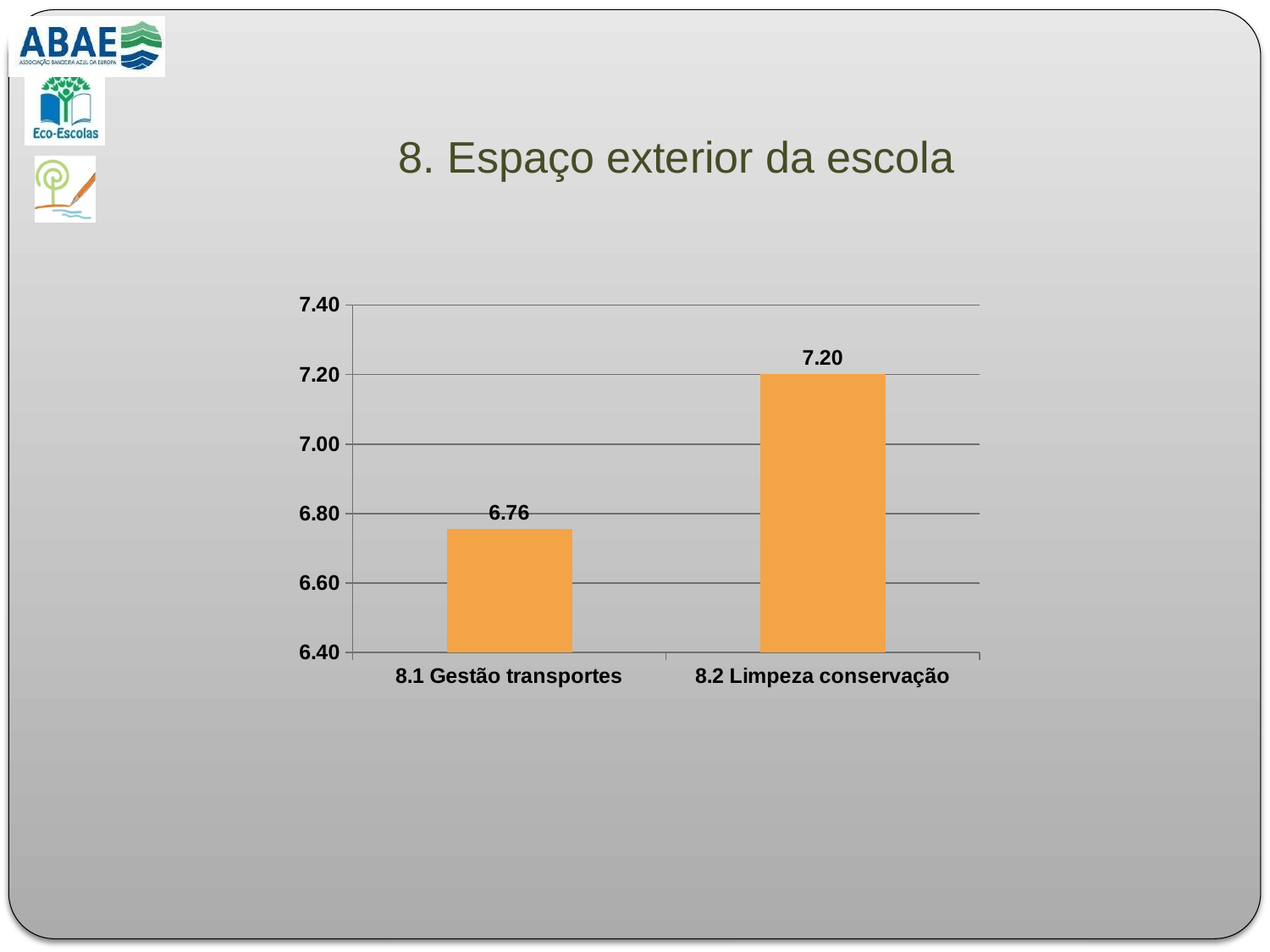
Which category has the highest value? 8.2 Limpeza conservação Which is larger, the value for 8.1 Gestão transportes or the value for 8.2 Limpeza conservação? 8.2 Limpeza conservação What is the value for 8.2 Limpeza conservação? 7.20 Is the value for 8.1 Gestão transportes greater or less than 7.00? less How many categories are shown on the chart? 2 What is the difference between the values for 8.2 Limpeza conservação and 8.1 Gestão transportes? 0.44 What colour are the bars in the chart? orange Which category has the lowest value? 8.1 Gestão transportes What is the value for 8.1 Gestão transportes? 6.76 Is the value for 8.2 Limpeza conservação greater or less than 7.00? greater What kind of chart is shown on the slide? bar chart What is the title of the slide containing the chart? 8. Espaço exterior da escola